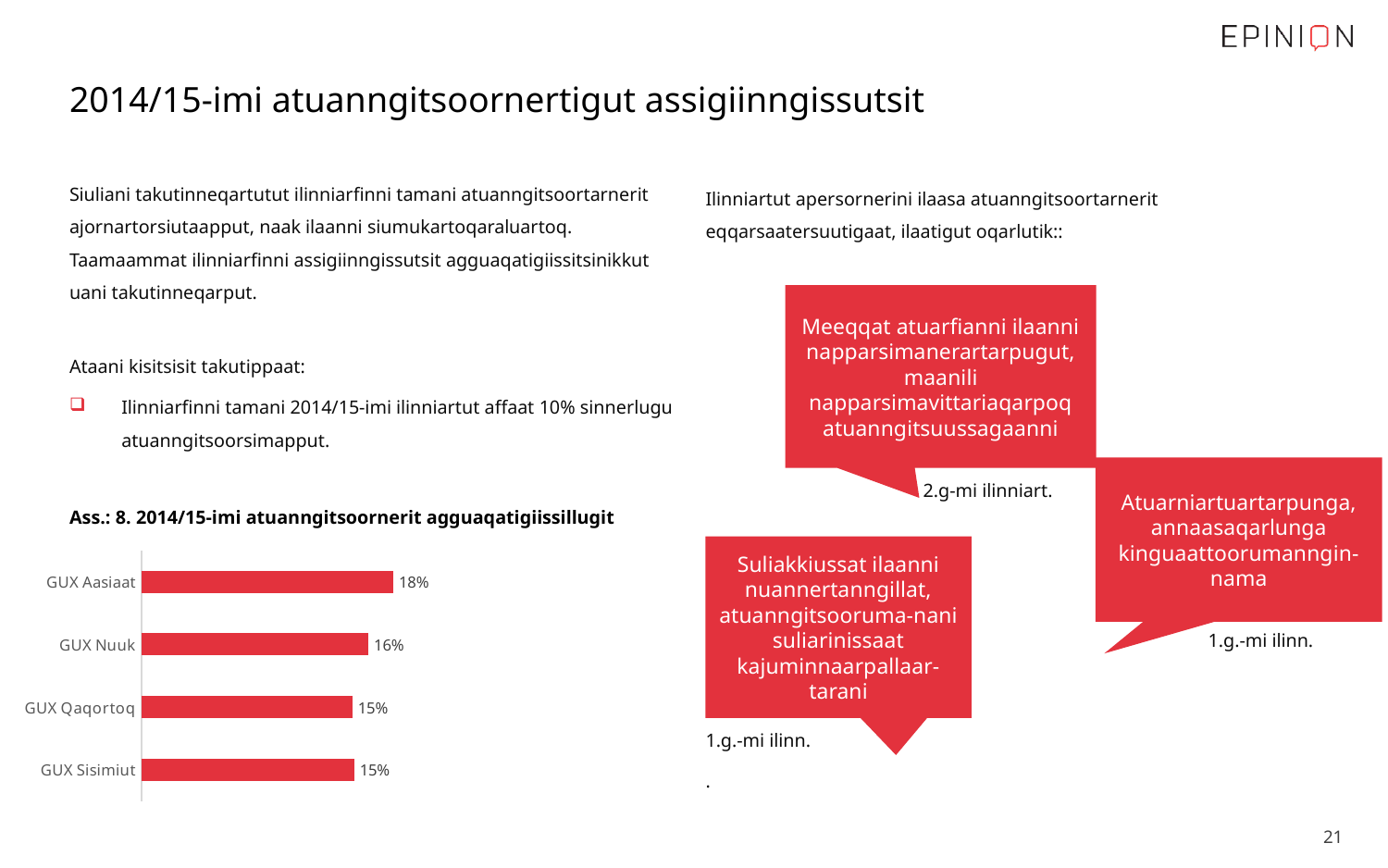
Which category has the highest value? GUX Aasiaat What is the value for GUX Sisimiut? 15% What colour are the bars in the chart? Red What is the value for GUX Aasiaat? 18% What is the difference between the values for GUX Aasiaat and GUX Sisimiut? 3% Which is larger, the value for GUX Nuuk or the value for GUX Qaqortoq? GUX Nuuk What kind of chart is shown on the slide? Bar chart What is the value for GUX Qaqortoq? 15% What is the title of the chart? Ass.: 8. 2014/15-imi atuanngitsoornerit agguaqatigiissillugit What is the value for GUX Nuuk? 16% How many categories are shown in the chart? 4 What is the difference between the values for GUX Aasiaat and GUX Nuuk? 2%